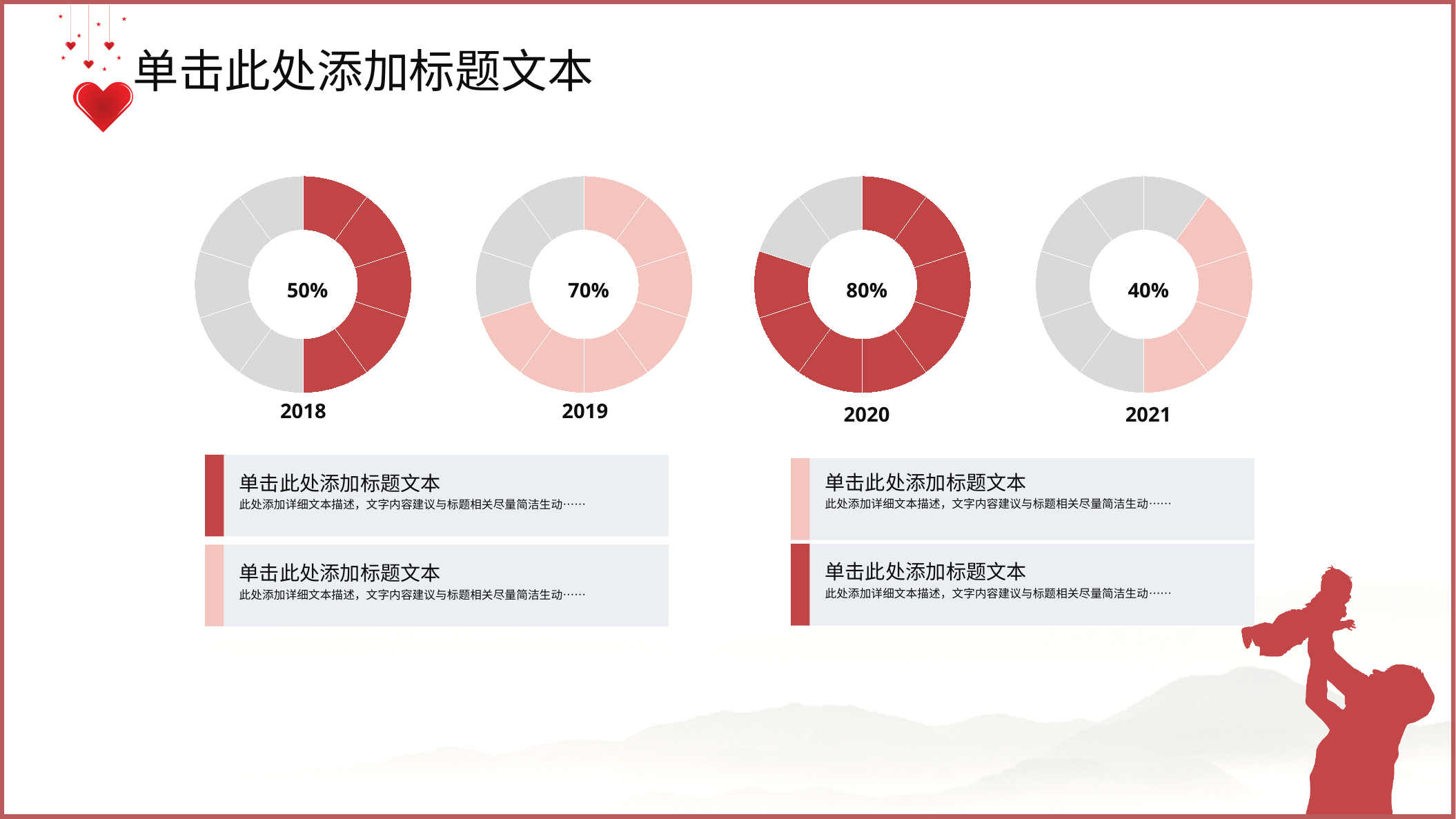
Across the four donut charts, which year shows the highest percentage? 2020 Across the four donut charts, which year shows the lowest percentage? 2021 What is the difference between the percentage in the 2020 donut chart and the percentage in the 2018 donut chart? 30% What percentage is shown in the centre of the 2020 donut chart? 80% What percentage is shown in the centre of the 2019 donut chart? 70% Into how many segments is the ring of the 2018 donut chart divided? 10 What percentage is shown in the centre of the 2021 donut chart? 40% What kind of chart is used for the 2018 figure? Donut chart How many donut charts are shown on the slide? 4 Do the percentages rise or fall from the 2020 donut chart to the 2021 donut chart? Fall Which is larger, the percentage in the 2019 donut chart or the percentage in the 2021 donut chart? 2019 What percentage is shown in the centre of the 2018 donut chart? 50%